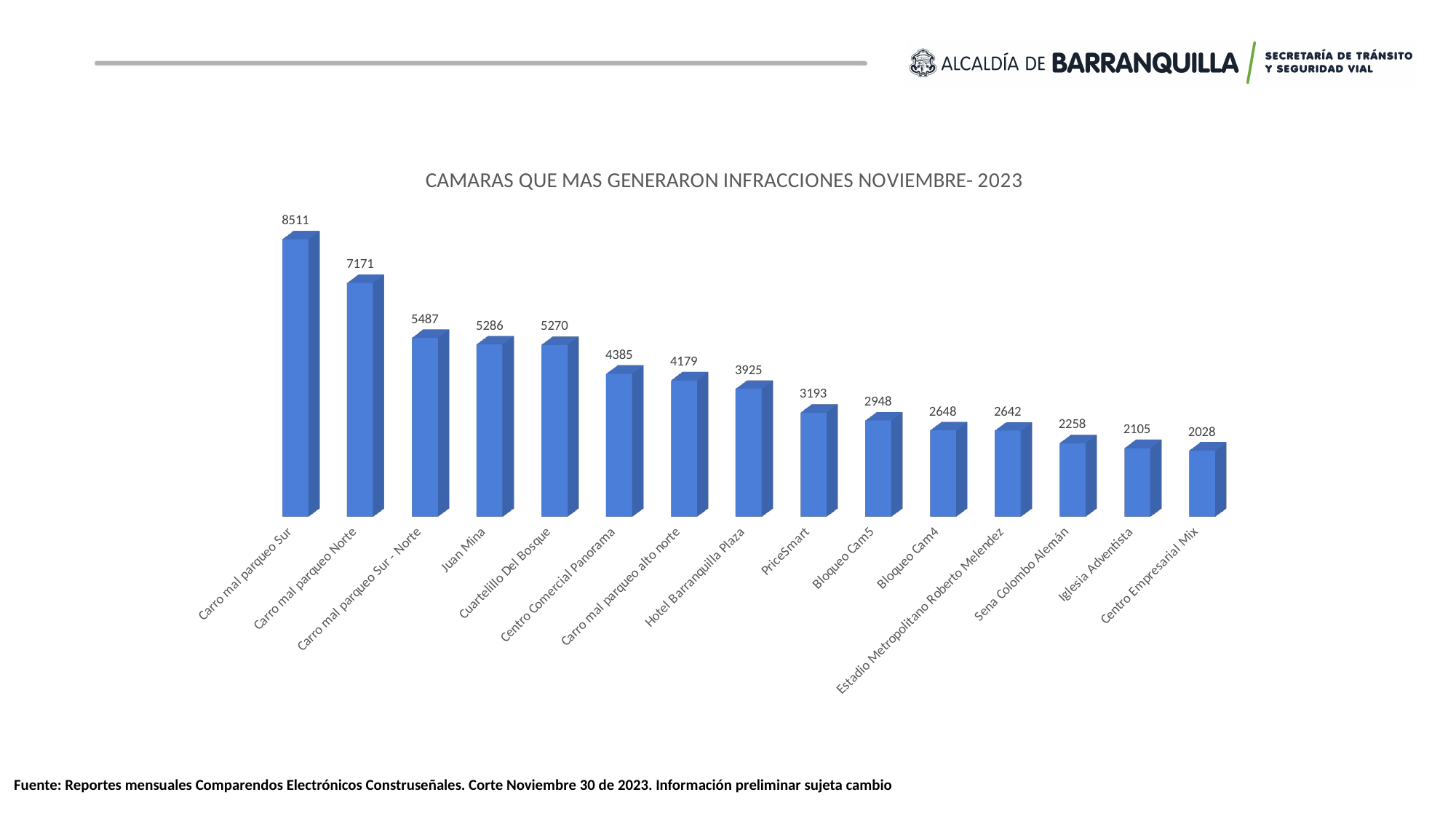
Which camera has the lowest value? Centro Empresarial Mix What is the title of the chart? CAMARAS QUE MAS GENERARON INFRACCIONES NOVIEMBRE- 2023 What is the difference between Carro mal parqueo Sur and Carro mal parqueo Norte? 1340 What is the value for Bloqueo Cam5? 2948 How many cameras are shown in the chart? 15 Which camera has the highest value? Carro mal parqueo Sur Which is larger, Centro Comercial Panorama or PriceSmart? Centro Comercial Panorama Do the values rise or fall from left to right along the x axis? Fall What is the value for Carro mal parqueo Sur? 8511 What is the difference between Juan Mina and Cuartelillo Del Bosque? 16 What kind of chart is this? Bar chart What is the value for Hotel Barranquilla Plaza? 3925